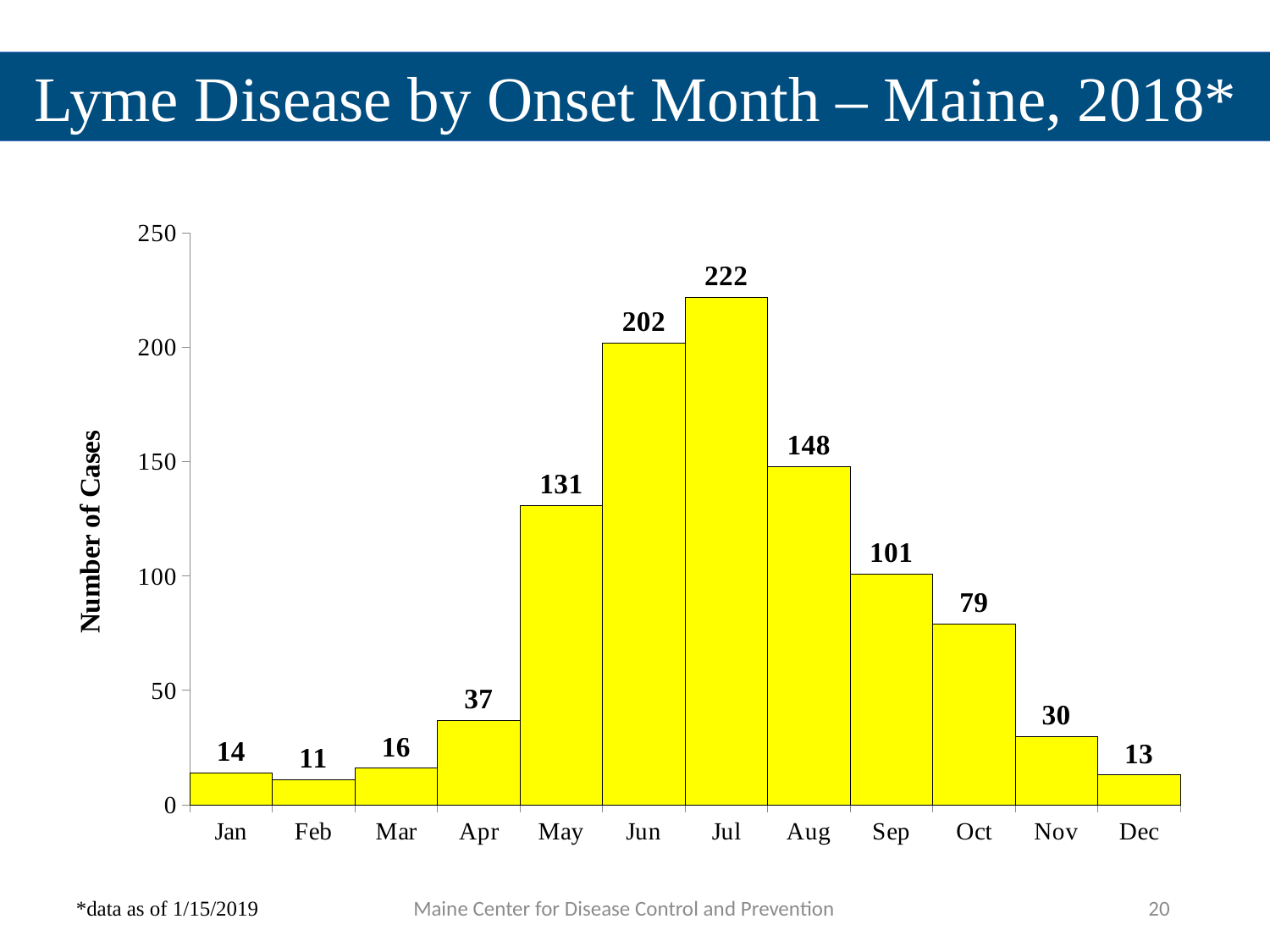
Which month has more cases, September or October? Sep What is the difference in cases between June and August? 54 Which month has the highest number of cases? Jul Which month has the lowest number of cases? Feb How many months are shown on the x axis? 12 Is the value for May greater or less than 100? greater Do the values rise or fall from July to December? fall How many cases are shown for July? 222 What is the number of cases for April? 37 What is the title of the chart? Lyme Disease by Onset Month – Maine, 2018* What is the label of the y axis? Number of Cases What kind of chart is shown on the slide? bar chart